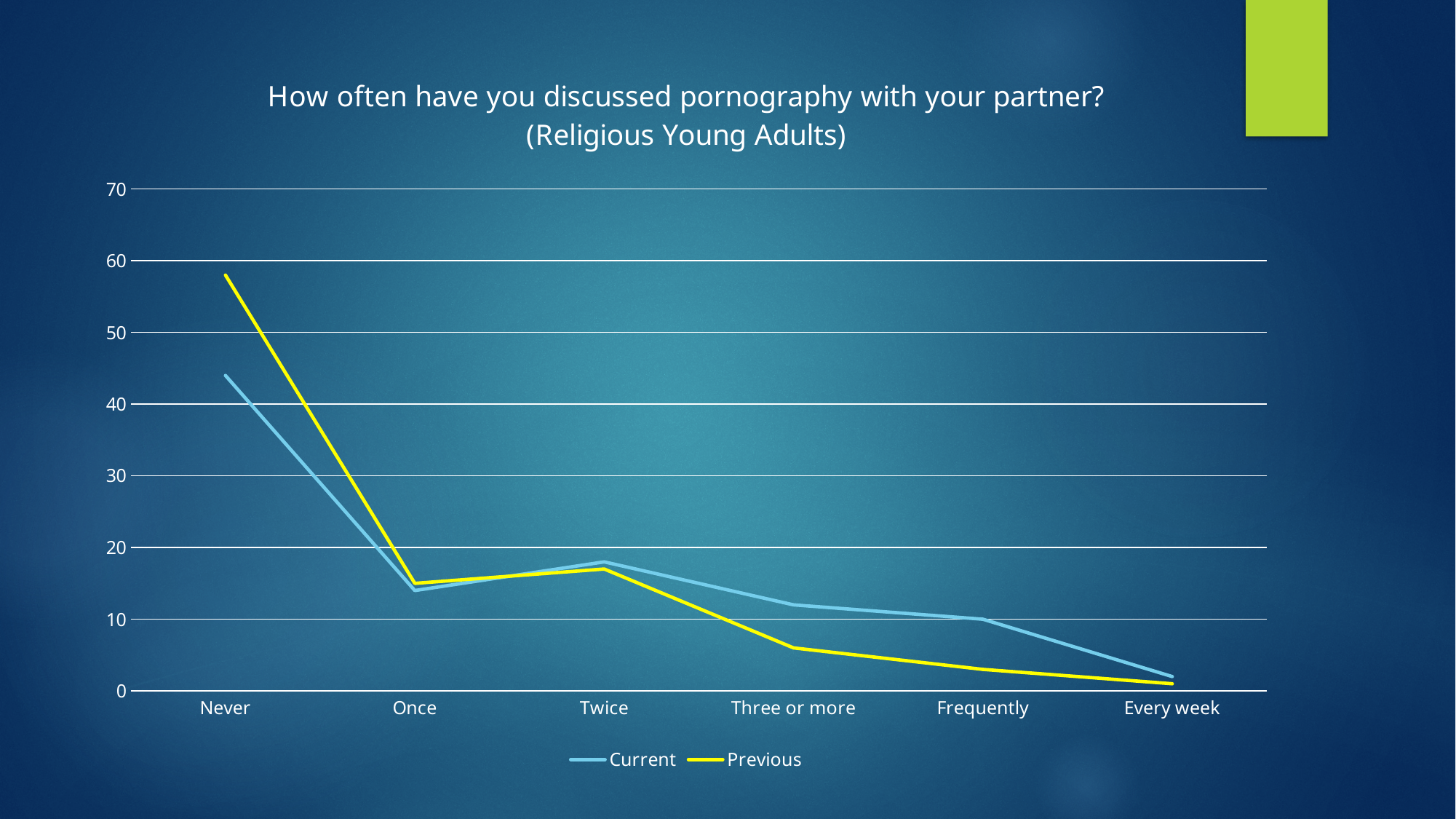
For the Never category, which series has the larger value, Current or Previous? Previous For the Frequently category, which series has the larger value, Current or Previous? Current Is the value for Three or more in the Previous series greater or less than 10? less How many categories are shown on the x axis? 6 How many series does the legend list? 2 Which category has the highest value for the Current series? Never What kind of chart is shown on the slide? line chart Is the value for Never in the Previous series greater or less than 50? greater Which category has the highest value for the Previous series? Never Is the value for Never in the Current series greater or less than 50? less Which category has the lowest value for the Current series? Every week What colour is the line for the Previous series? yellow